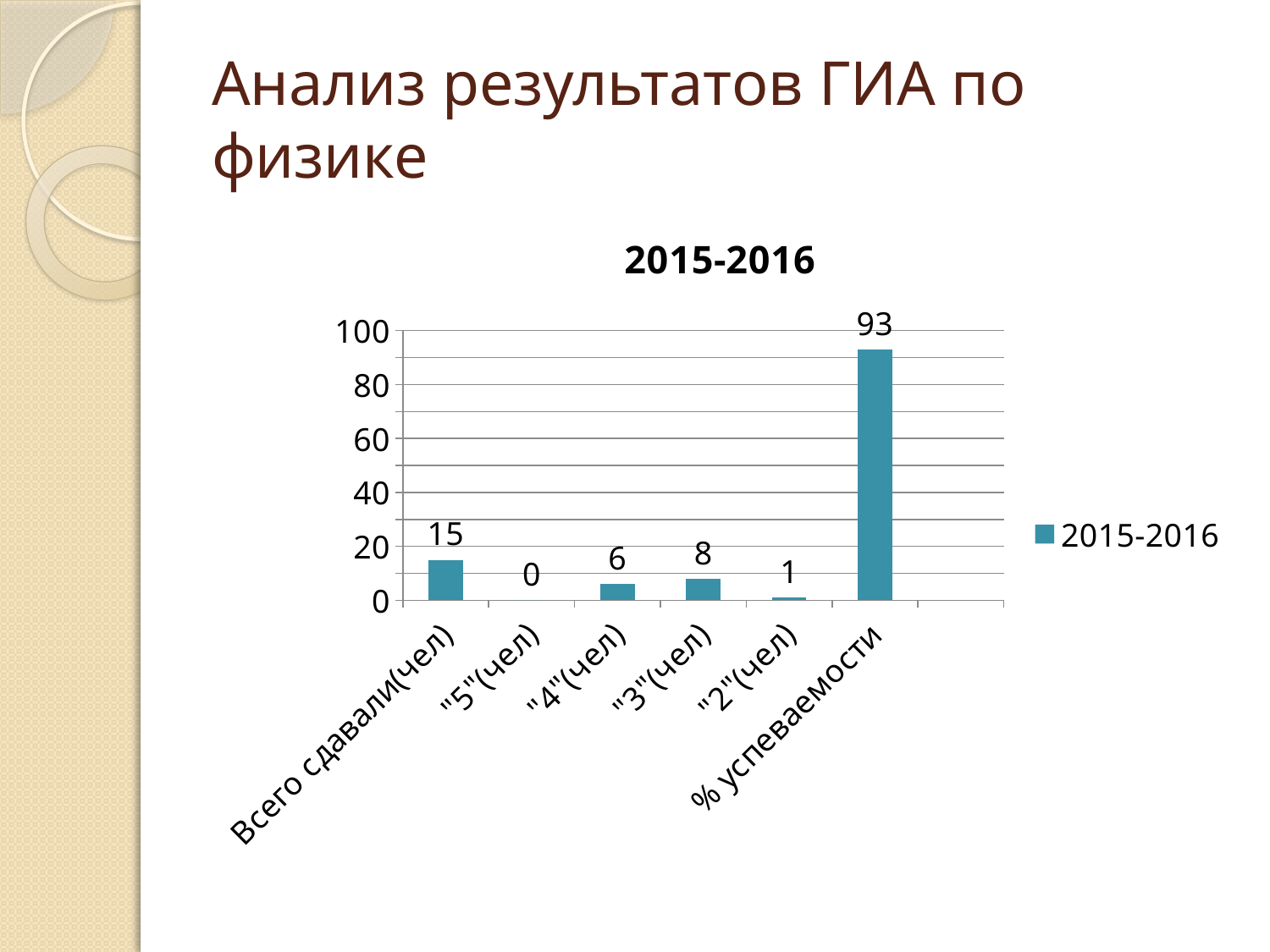
What is the value for ""3"(чел)"? 8 What kind of chart is shown? bar chart What is the title of the chart? 2015-2016 What is the value for "Всего сдавали(чел)"? 15 Which category has the lowest value? "5"(чел) How many categories are shown on the x axis? 6 Which category has the highest value? % успеваемости What is the difference between the values for ""3"(чел)" and ""4"(чел)"? 2 What is the value for ""4"(чел)"? 6 Which is larger: the value for ""3"(чел)" or ""2"(чел)"? "3"(чел) What is the value for ""5"(чел)"? 0 What is the value for "% успеваемости"? 93